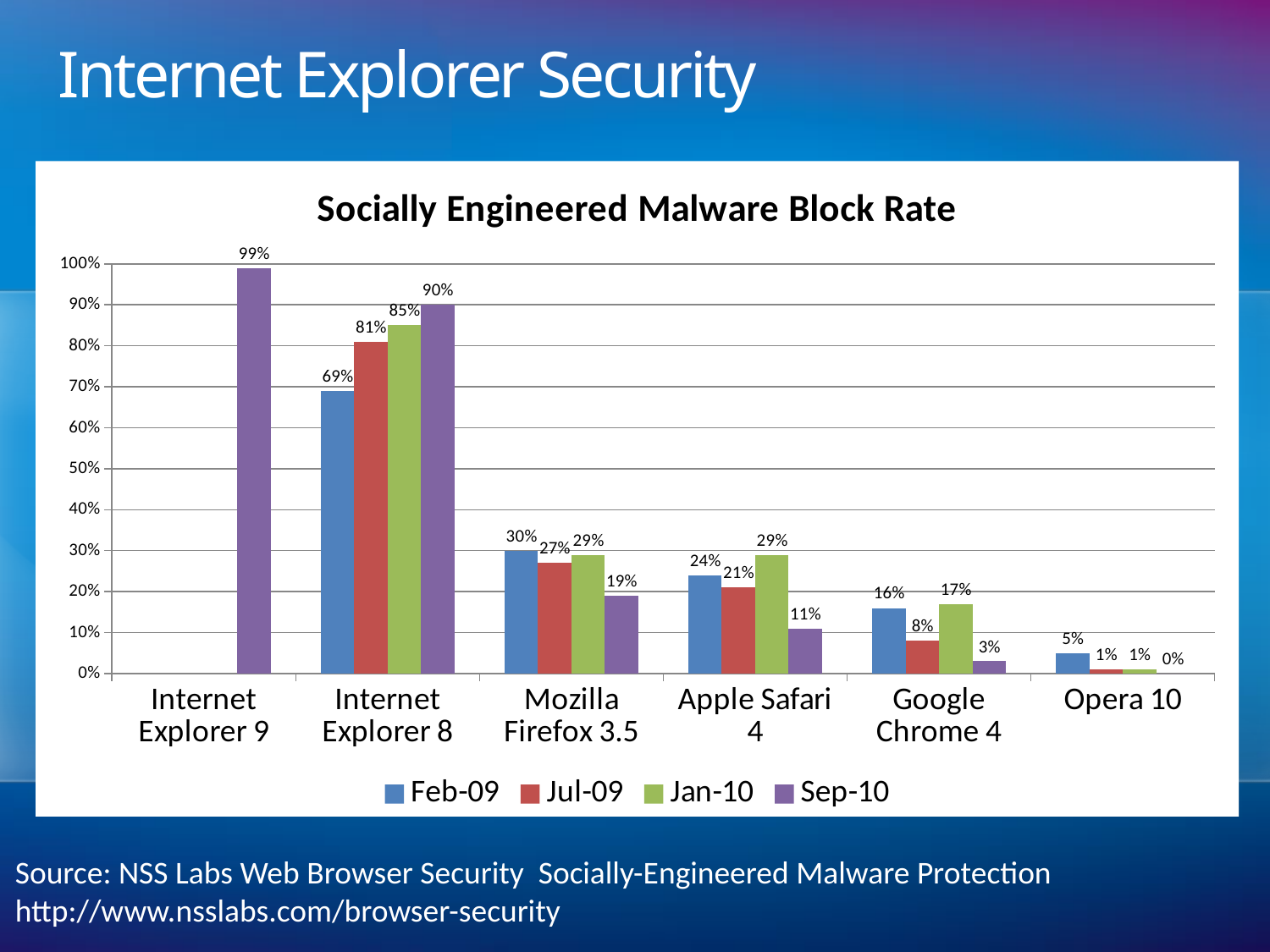
Which browser has the highest Sep-10 block rate? Internet Explorer 9 What is the title of the chart? Socially Engineered Malware Block Rate Which is larger: the Jul-09 block rate for Mozilla Firefox 3.5 or the Jul-09 block rate for Apple Safari 4? Mozilla Firefox 3.5 What is the Feb-09 block rate for Internet Explorer 8? 69% What is the Sep-10 block rate for Internet Explorer 9? 99% How many series does the legend list? 4 How many browsers are shown on the x axis? 6 What is the Jan-10 block rate for Apple Safari 4? 29% What kind of chart is this? Bar chart What is the Sep-10 block rate for Google Chrome 4? 3% What is the difference between the Sep-10 and Feb-09 block rates for Internet Explorer 8? 21% Which browser has the lowest Jan-10 block rate? Opera 10